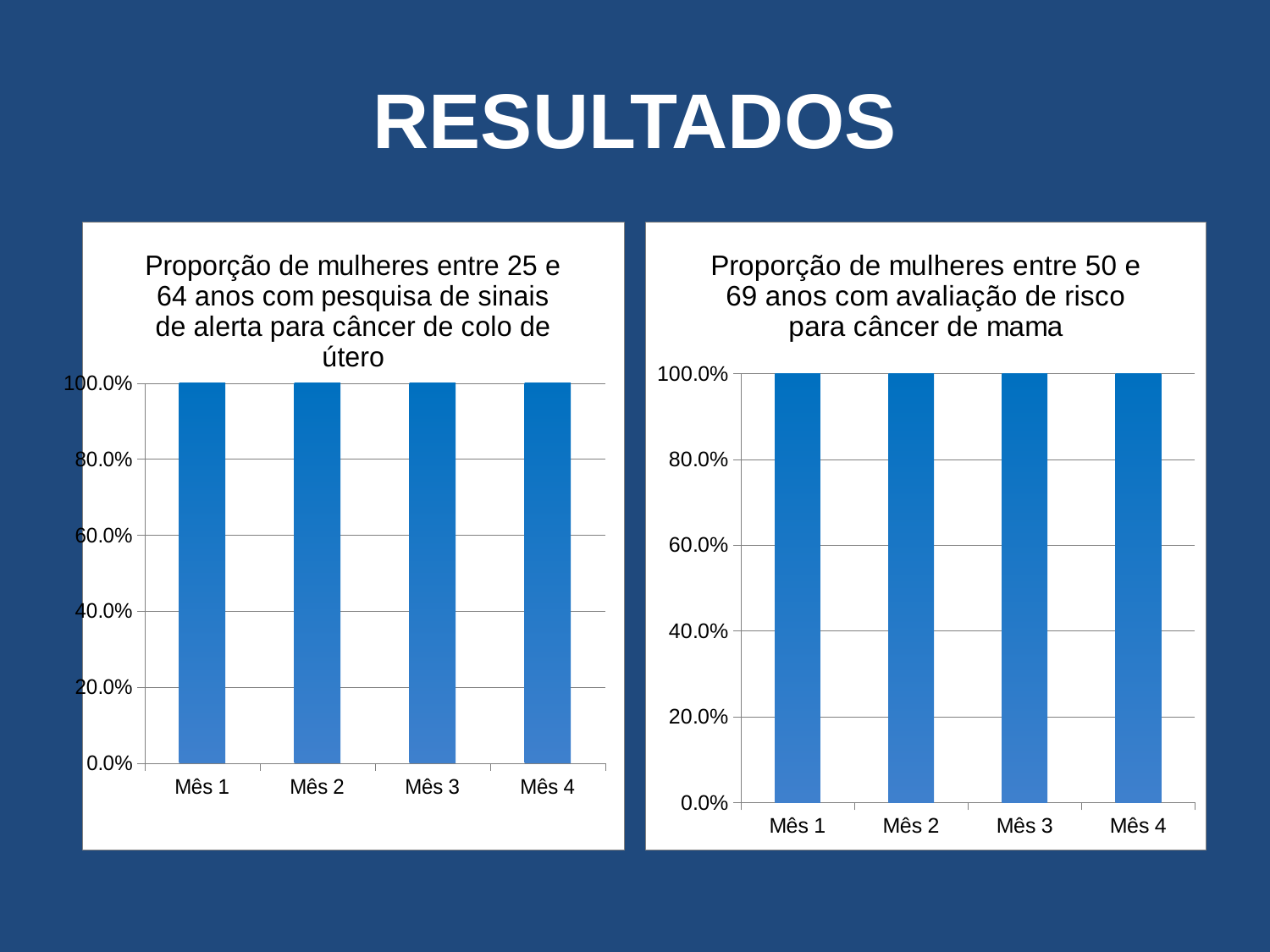
How many categories are shown on the x axis of the left chart? 4 In the left chart, is the value for Mês 2 greater or less than 80.0%? greater In the right chart, is the value for Mês 3 greater or less than 60.0%? greater How many bars are plotted in the right chart? 4 In the right chart, what is the value for Mês 2? 100.0% In the left chart (Proporção de mulheres entre 25 e 64 anos), what is the value for Mês 1? 100.0% In the left chart, what is the value for Mês 3? 100.0% What is the title of the right chart? Proporção de mulheres entre 50 e 69 anos com avaliação de risco para câncer de mama What kind of chart is the left chart? bar chart In the right chart (Proporção de mulheres entre 50 e 69 anos), what is the value for Mês 4? 100.0% What kind of chart is the right chart? bar chart In the right chart, what is the difference between the values for Mês 1 and Mês 4? 0.0%